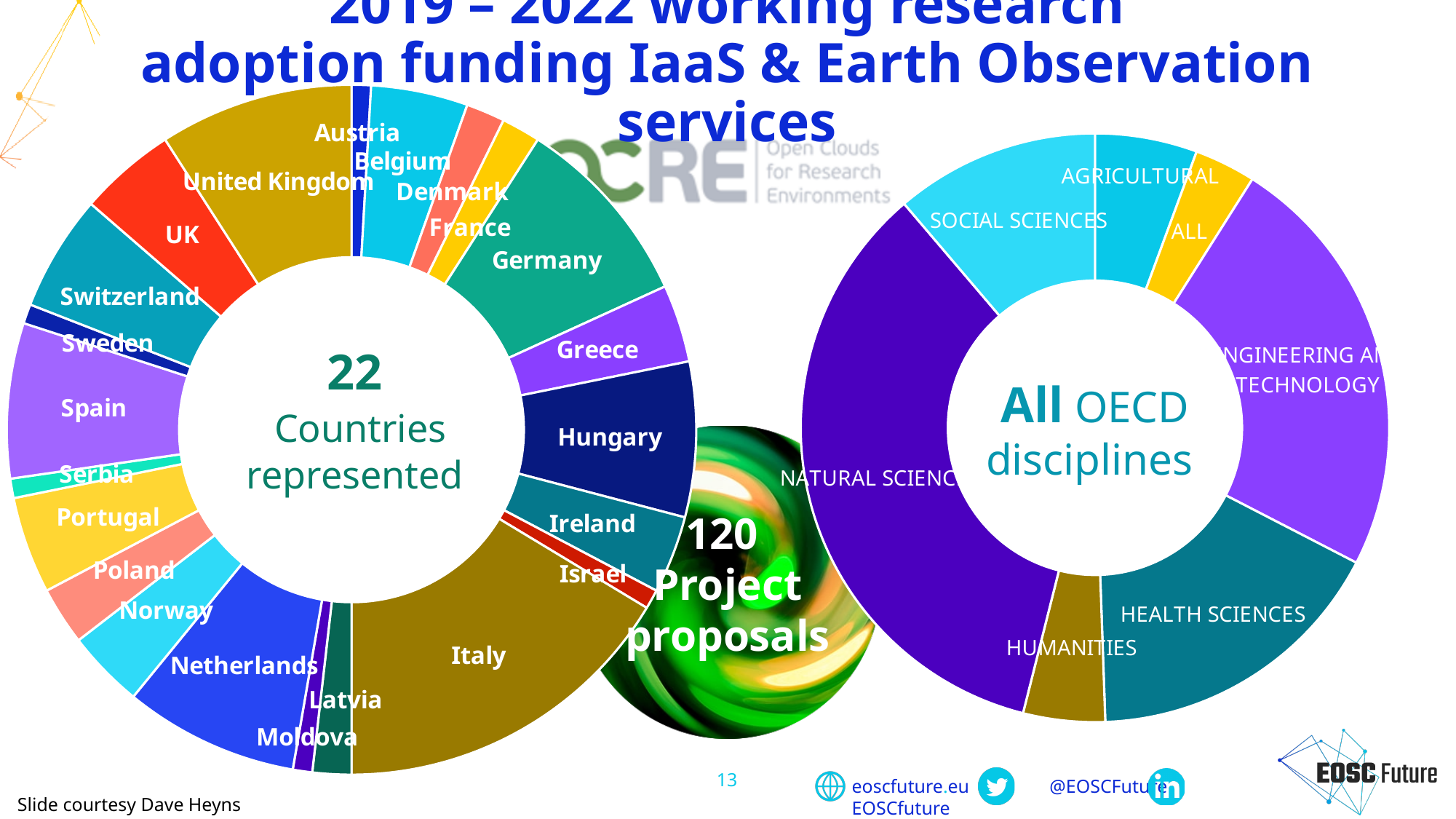
How many project proposals does the slide state between the two charts? 120 What text appears in the centre of the right chart? All OECD disciplines In the right chart, which slice is larger, Engineering and Technology or Humanities? Engineering and Technology In the right chart, which discipline has the largest slice? Natural Sciences What kind of chart is the right chart showing OECD disciplines? donut (pie) chart According to the text in the centre of the left chart, how many countries are represented? 22 What kind of chart is the left chart showing countries represented? donut (pie) chart In the right chart, which slice is larger, Natural Sciences or Health Sciences? Natural Sciences How many discipline categories are labelled on the right chart? 7 In the left chart, which slice is larger, United Kingdom or Hungary? United Kingdom In the left chart, which country has the largest slice? Italy